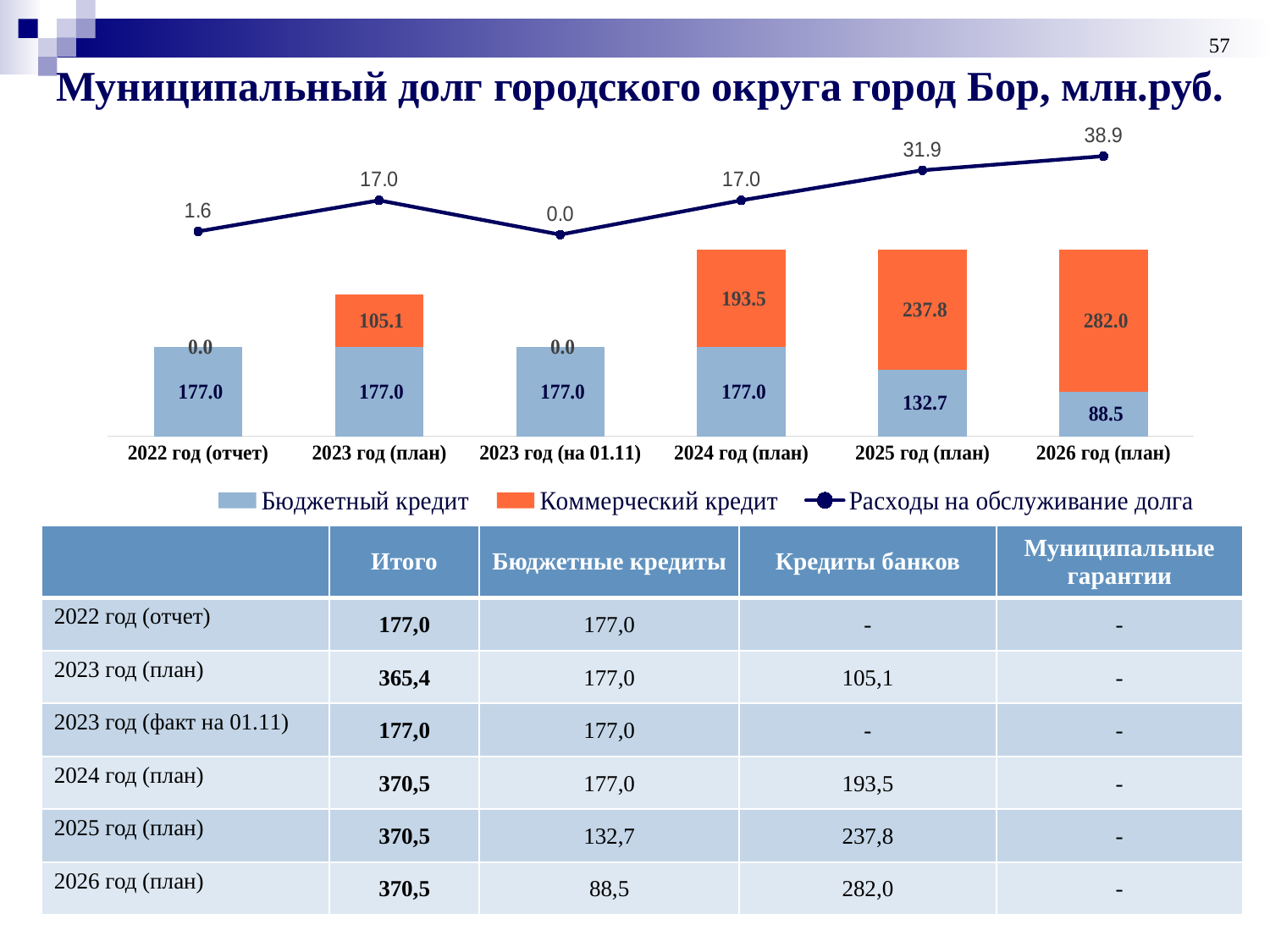
What kind of chart is shown on the slide? Stacked bar chart with a line What is the value of Расходы на обслуживание долга for 2025 год (план)? 31.9 What is the difference between Коммерческий кредит for 2026 год (план) and 2025 год (план)? 44.2 What is the title of the chart? Муниципальный долг городского округа город Бор, млн.руб. What is the total of the stacked bar for 2024 год (план)? 370.5 Which category has the highest value of Расходы на обслуживание долга? 2026 год (план) What is the value of Бюджетный кредит for 2026 год (план)? 88.5 How many series does the chart legend list? 3 How many categories are shown on the x axis of the chart? 6 What is the value of Коммерческий кредит for 2024 год (план)? 193.5 Which is larger: Бюджетный кредит for 2025 год (план) or Коммерческий кредит for 2025 год (план)? Коммерческий кредит Which category has the lowest value of Бюджетный кредит? 2026 год (план)